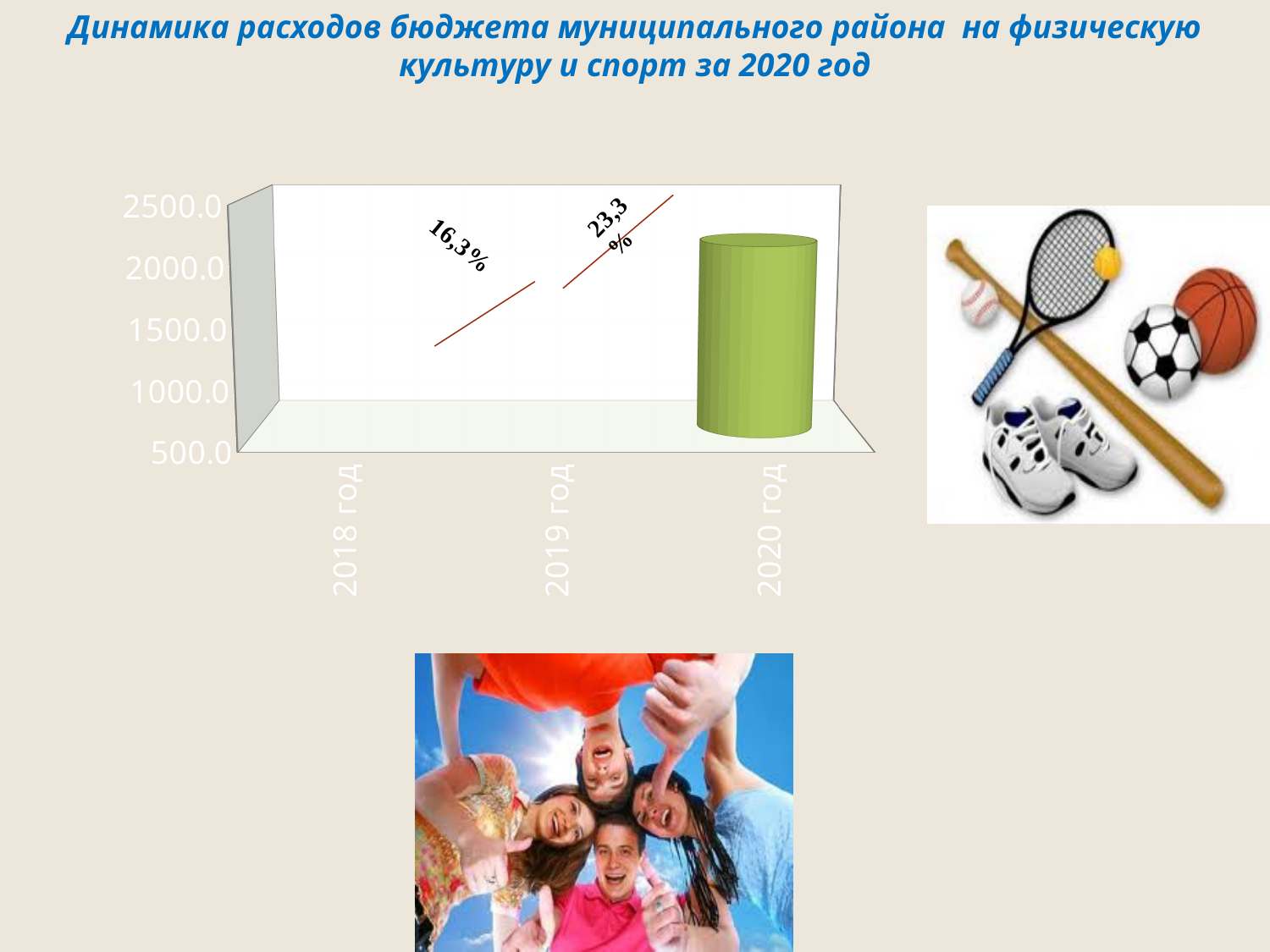
What percentage is written on the annotation between 2019 год and 2020 год? 23,3 % What colour is the bar for 2020 год? green What percentage is written on the annotation between 2018 год and 2019 год? 16,3% What is the highest value shown on the vertical axis of the chart? 2500.0 Is the value for 2020 год greater or less than 2500? less What kind of chart is shown on the slide? bar chart Which years are labelled on the x axis of the chart? 2018 год, 2019 год, 2020 год How many year categories are labelled on the x axis of the chart? 3 Is the value for 2020 год greater or less than 1500? greater Which category has the tallest bar in the chart? 2020 год